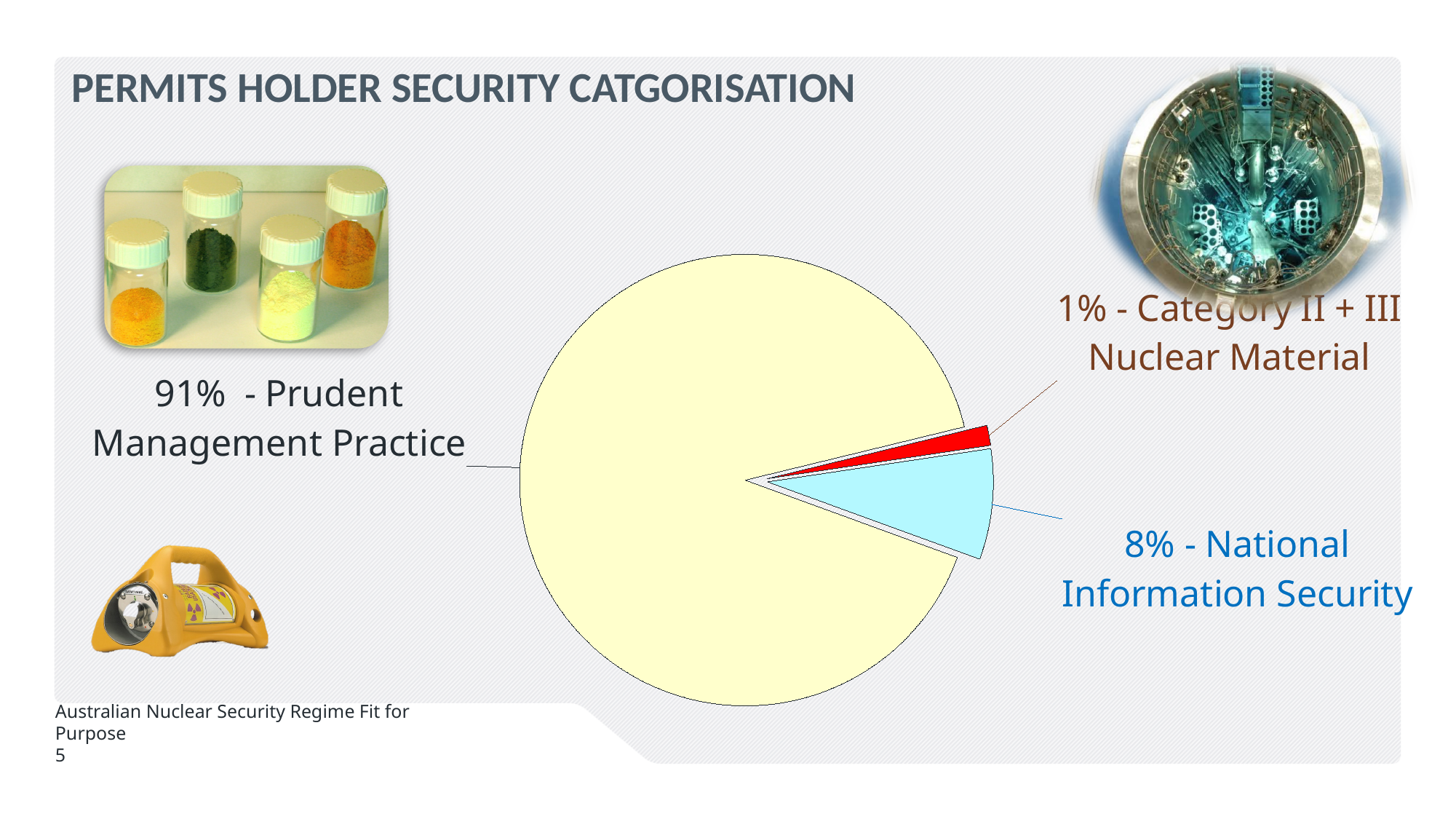
Which category has the smallest slice of the pie? Category II + III Nuclear Material What share of the pie is Prudent Management Practice? 91% Which is larger, the National Information Security slice or the Category II + III Nuclear Material slice? National Information Security What share of the pie is Category II + III Nuclear Material? 1% What kind of chart is shown on the slide? pie chart What share of the pie is National Information Security? 8% Which category has the largest slice of the pie? Prudent Management Practice What is the difference in percentage points between Prudent Management Practice and National Information Security? 83 How many slices does the pie chart have? 3 What is the difference in percentage points between National Information Security and Category II + III Nuclear Material? 7 What colour is the Category II + III Nuclear Material slice? red What is the title of the slide containing the pie chart? PERMITS HOLDER SECURITY CATGORISATION